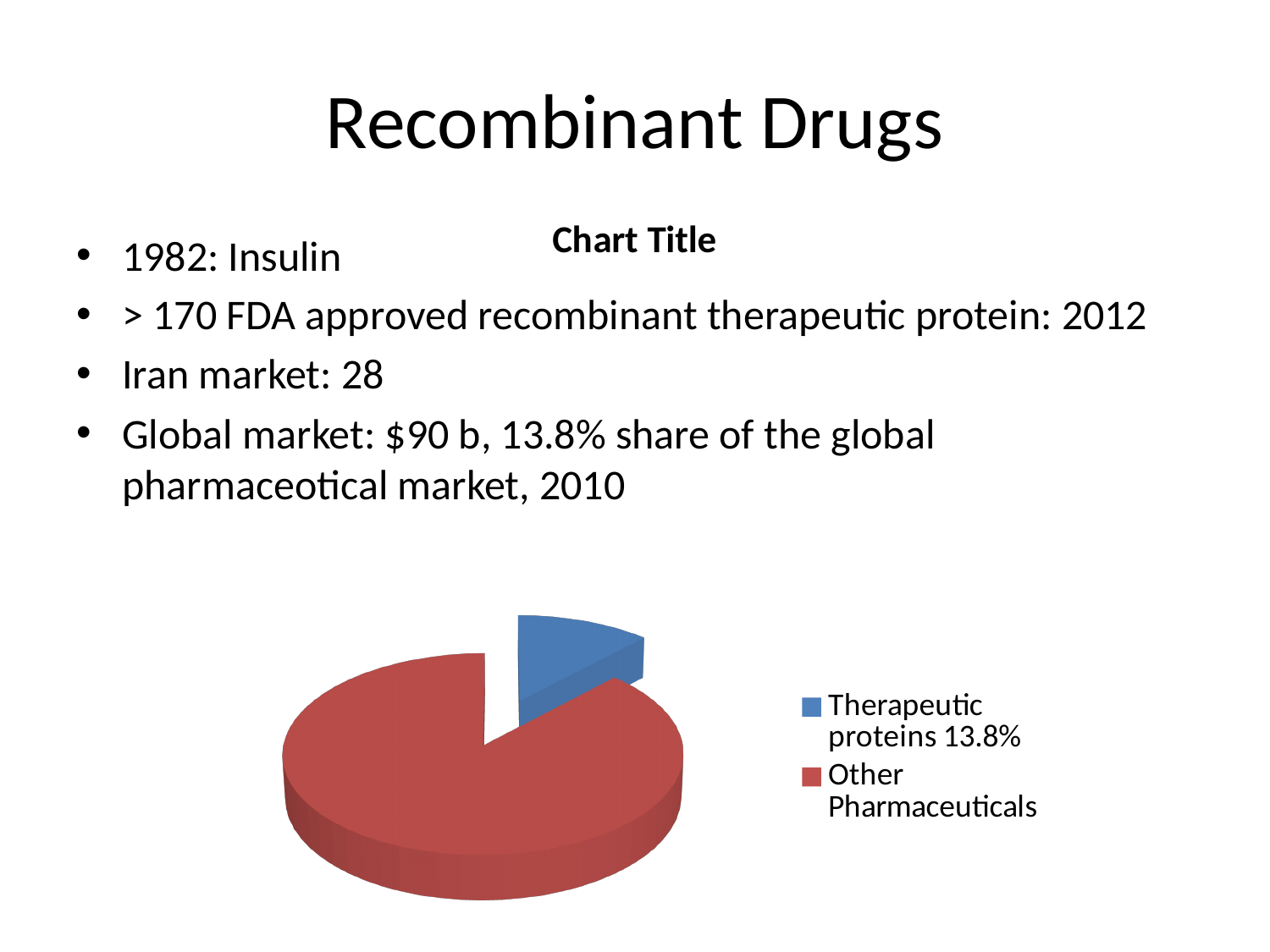
Which slice of the pie chart is the smallest? Therapeutic proteins How many slices does the pie chart have? 2 How many entries does the pie chart's legend list? 2 Which is larger in the pie chart, Therapeutic proteins or Other Pharmaceuticals? Other Pharmaceuticals What kind of chart is shown on the slide? pie chart Does the Other Pharmaceuticals slice take up more or less than half of the pie? more What is the title shown above the pie chart? Chart Title Which slice of the pie chart is the largest? Other Pharmaceuticals What share of the pie do Therapeutic proteins account for? 13.8% What colour is the Therapeutic proteins slice in the pie chart? blue